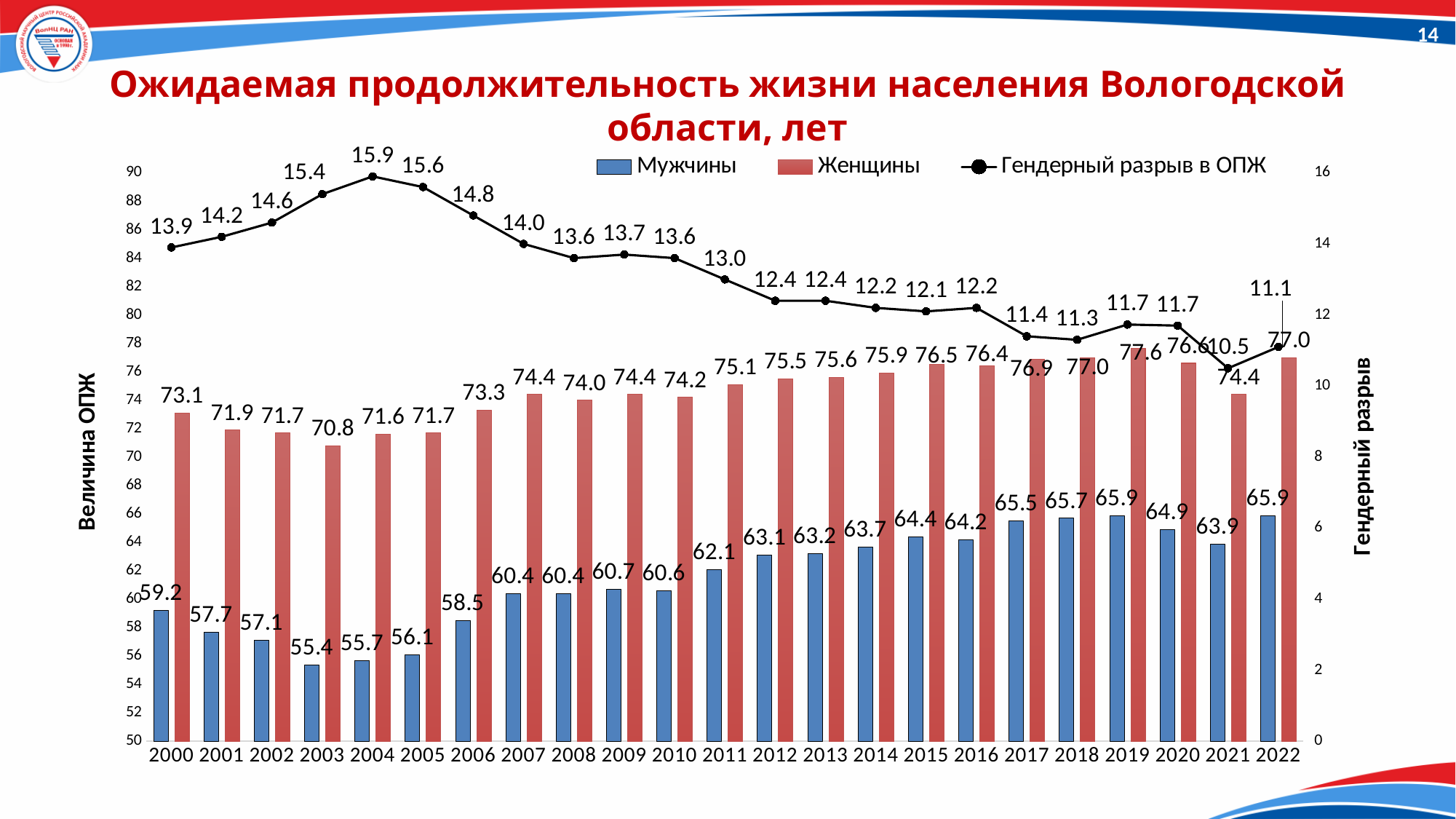
By how much did the men's (Мужчины) life expectancy value change from 2000 to 2022? 6.7 What is the gender gap (Гендерный разрыв в ОПЖ) value in 2011? 13.0 In which year is the value for men (Мужчины) lowest? 2003 What is the overall trend of the gender gap line from 2004 to 2022? falling In which year is the gender gap (Гендерный разрыв в ОПЖ) lowest? 2021 What is the life expectancy value for men (Мужчины) in 2003? 55.4 How many series does the legend list? 3 How many years are shown on the x axis? 23 What is the difference between the women's and men's life expectancy values in 2022? 11.1 In which year is the gender gap (Гендерный разрыв в ОПЖ) highest? 2004 Which is larger: the women's value in 2021 or the women's value in 2020? 2020 What is the life expectancy value for women (Женщины) in 2019? 77.6